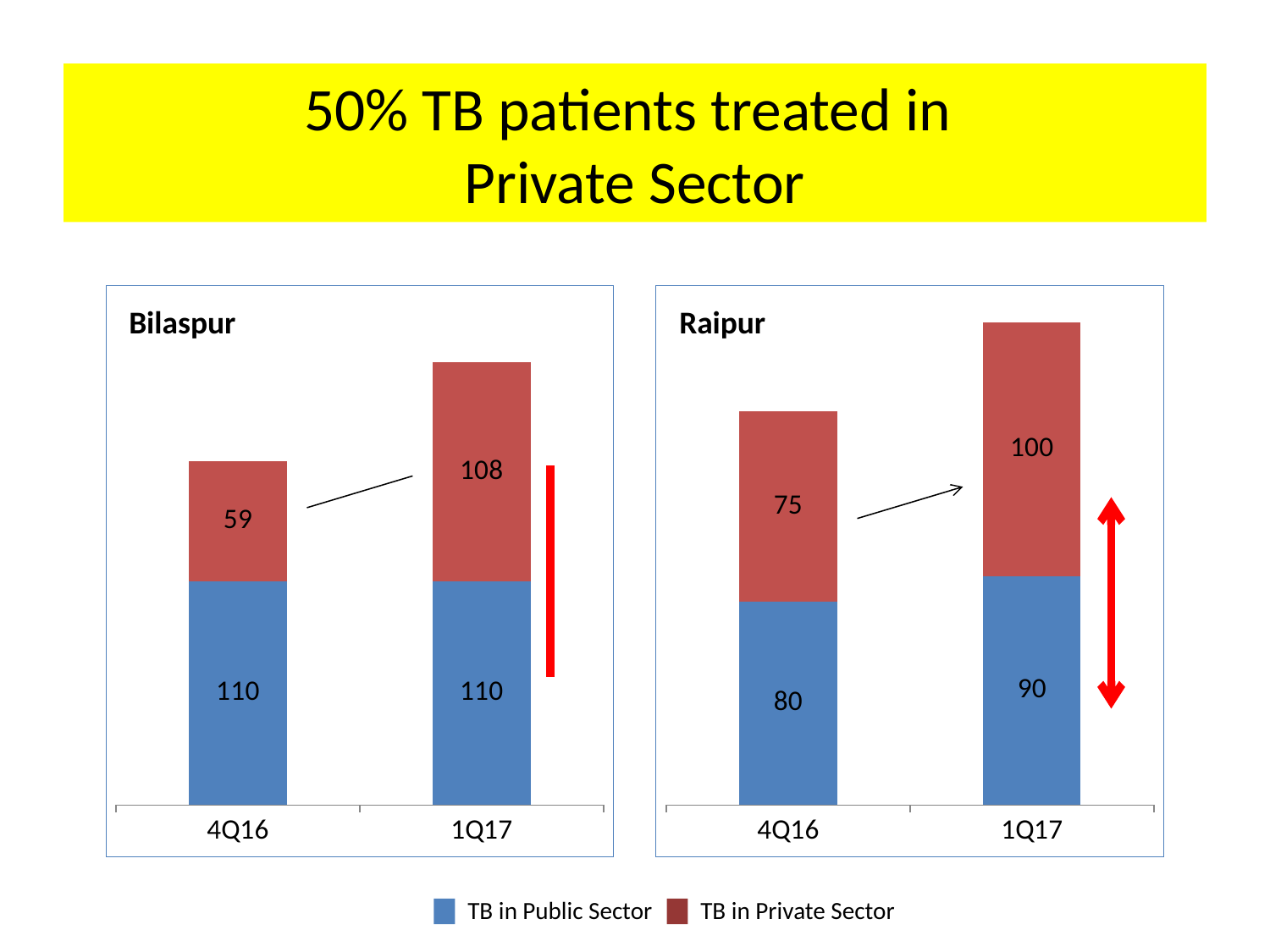
In the Raipur chart, what is the total of the stacked bar for 4Q16? 155 In the Bilaspur chart, which quarter has the higher TB in Private Sector value? 1Q17 In the Bilaspur chart, what is the value for TB in Public Sector in 4Q16? 110 In the Raipur chart, what is the value for TB in Private Sector in 1Q17? 100 What kind of chart is the Raipur chart? stacked bar chart In the Bilaspur chart, what is the total of the stacked bar for 1Q17? 218 In the Raipur chart, what is the value for TB in Public Sector in 4Q16? 80 In the Bilaspur chart, what is the value for TB in Private Sector in 1Q17? 108 In the Raipur chart, what is the difference between the TB in Private Sector values for 1Q17 and 4Q16? 25 In the Raipur chart, is the TB in Public Sector value for 1Q17 larger or smaller than the value for 4Q16? larger How many series does the legend list? 2 In the Bilaspur chart, does the TB in Private Sector value rise or fall from 4Q16 to 1Q17? rise